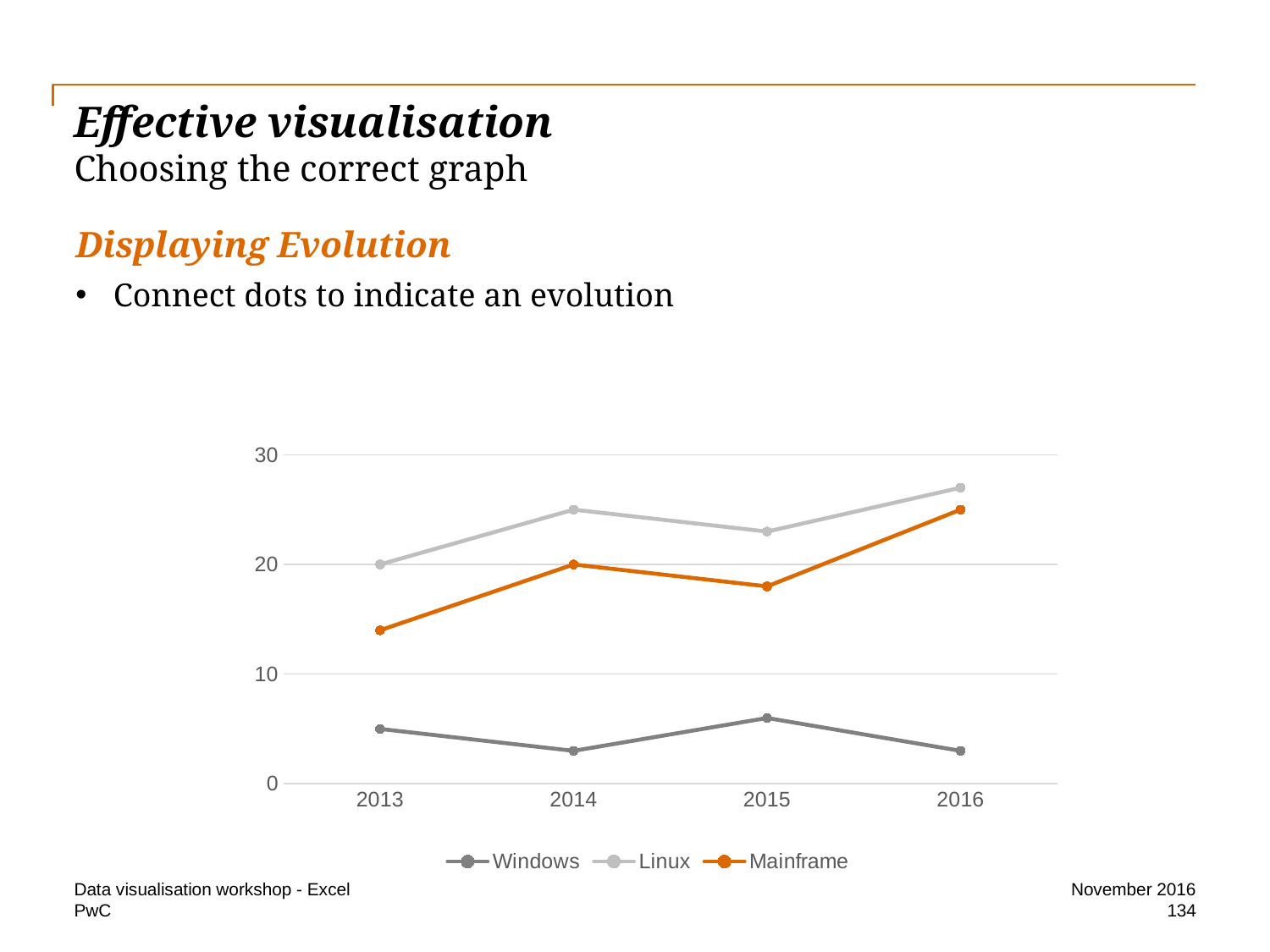
What is the value for Linux in 2013? 20 Is the value for Windows in 2015 greater or less than 10? less What is the value for Mainframe in 2014? 20 In 2013, which is larger, the value for Linux or the value for Mainframe? Linux Which series has the lowest value in 2014? Windows How many series does the legend list? 3 Which series has the highest value in 2016? Linux What kind of chart is shown on the slide? line chart Is the value for Mainframe in 2013 greater or less than 20? less Is the value for Linux in 2016 greater or less than 30? less How many years are shown on the x axis? 4 Does the Mainframe series rise or fall from 2015 to 2016? rise